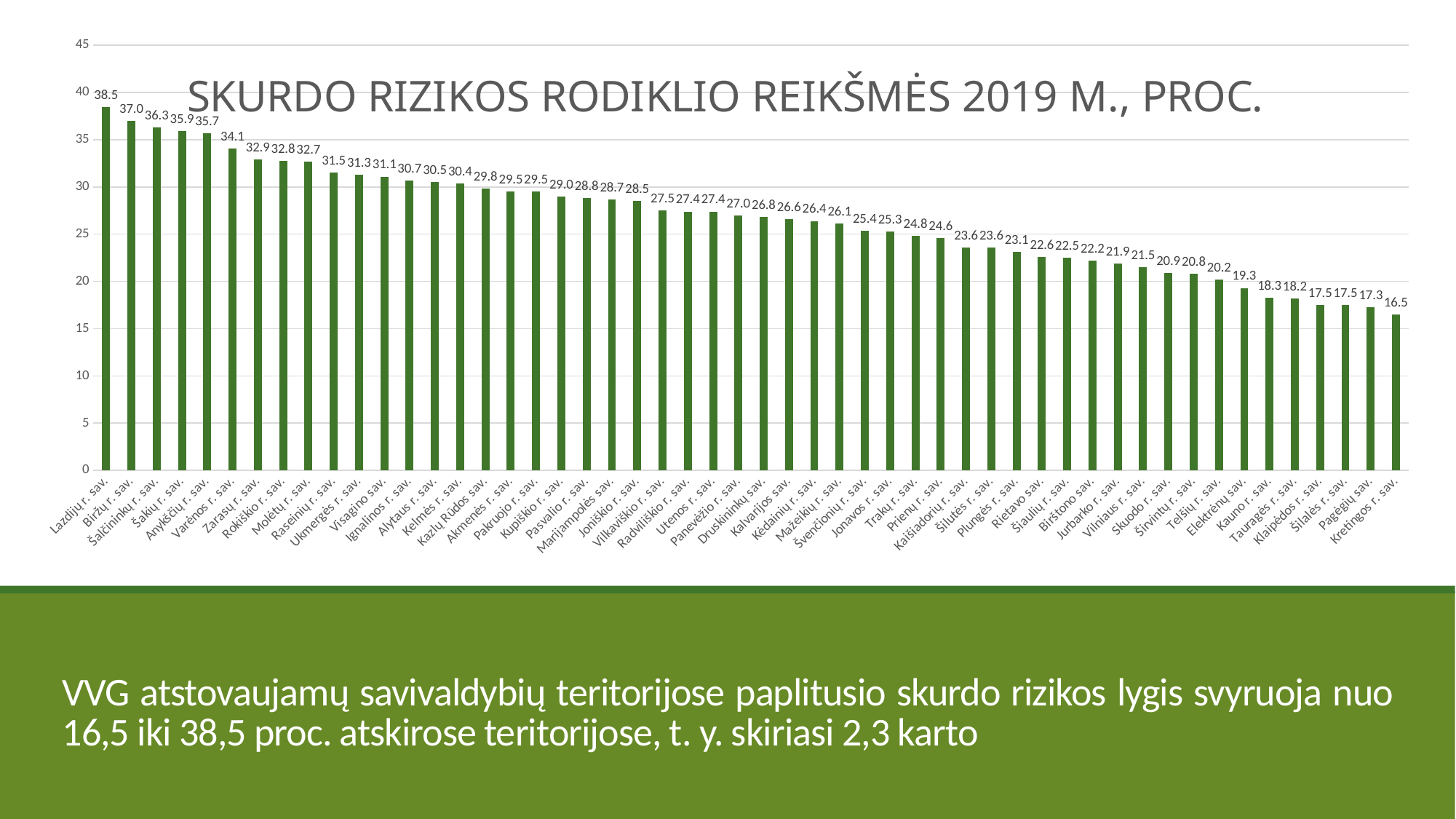
What is the value for Kauno r. sav.? 18.3 Which category has the lowest value? Kretingos r. sav. What kind of chart is shown on the slide? bar chart Do the values rise or fall from left to right along the x axis? fall What is the value for Lazdijų r. sav.? 38.5 Which category has the highest value? Lazdijų r. sav. What is the difference between the values for Lazdijų r. sav. and Kretingos r. sav.? 22.0 What is the value for Varėnos r. sav.? 34.1 Is the value for Panevėžio r. sav. greater or less than 30? less What is the value for Vilniaus r. sav.? 21.5 Which is larger, the value for Biržų r. sav. or the value for Telšių r. sav.? Biržų r. sav. What is the title of the chart? SKURDO RIZIKOS RODIKLIO REIKŠMĖS 2019 M., PROC.